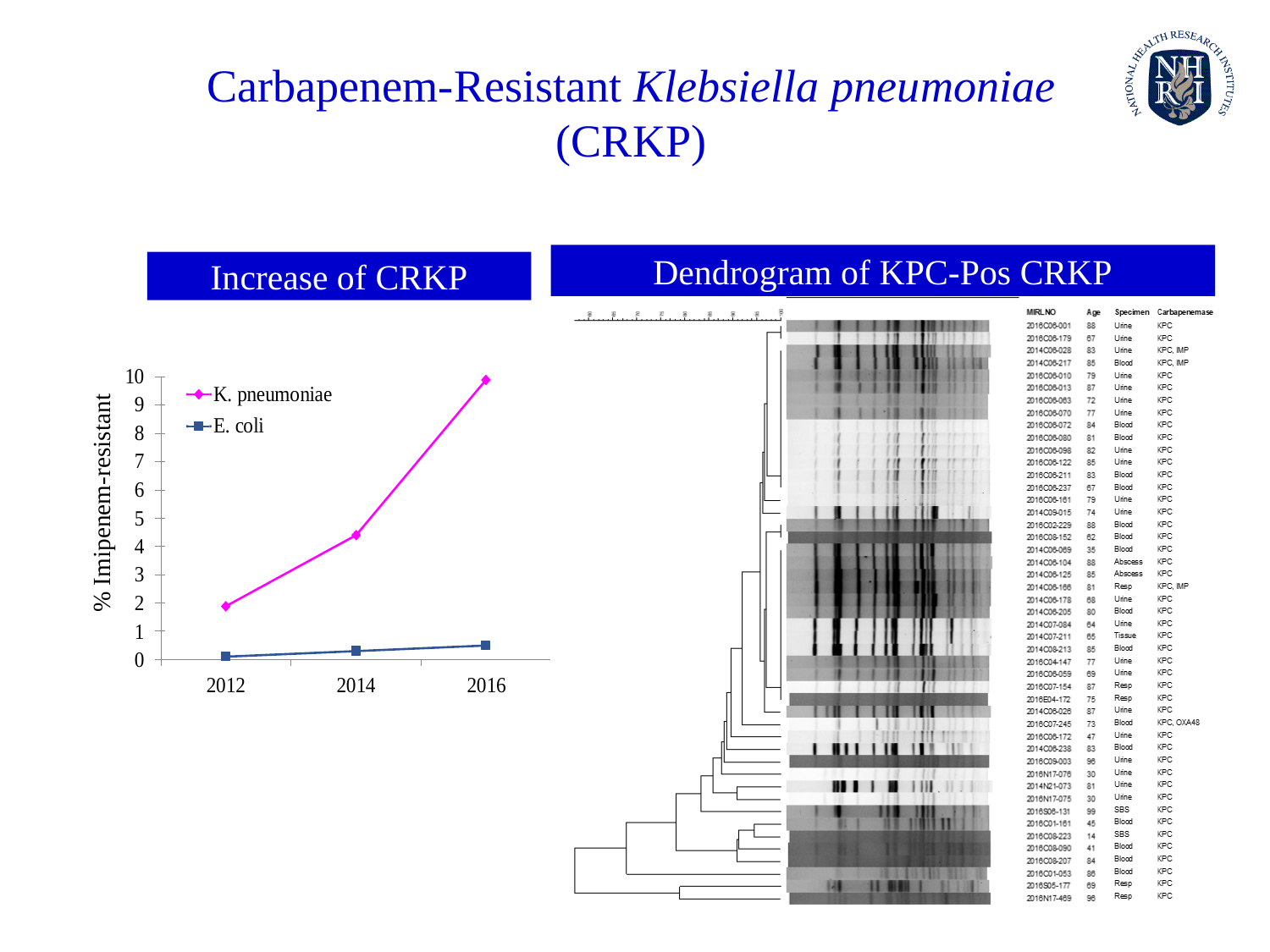
In the 'Increase of CRKP' chart, which series has the higher value in 2016, K. pneumoniae or E. coli? K. pneumoniae In the 'Increase of CRKP' chart, in which year is the K. pneumoniae value lowest? 2012 How many years are shown on the x axis of the 'Increase of CRKP' chart? 3 How many series does the legend of the 'Increase of CRKP' chart list? 2 In the 'Increase of CRKP' chart, what colour is the K. pneumoniae line? magenta (pink) In the 'Increase of CRKP' chart, is the K. pneumoniae value for 2016 greater or less than 9? greater In the 'Increase of CRKP' chart, is the E. coli value for 2016 greater or less than 1? less In the 'Increase of CRKP' chart, in which year is the K. pneumoniae value highest? 2016 In the 'Increase of CRKP' chart, does the K. pneumoniae line rise or fall from 2012 to 2016? rise In the 'Increase of CRKP' chart, is the K. pneumoniae value for 2014 greater or less than 5? less What is the y-axis label of the 'Increase of CRKP' chart? % Imipenem-resistant What kind of chart is the 'Increase of CRKP' chart? line chart